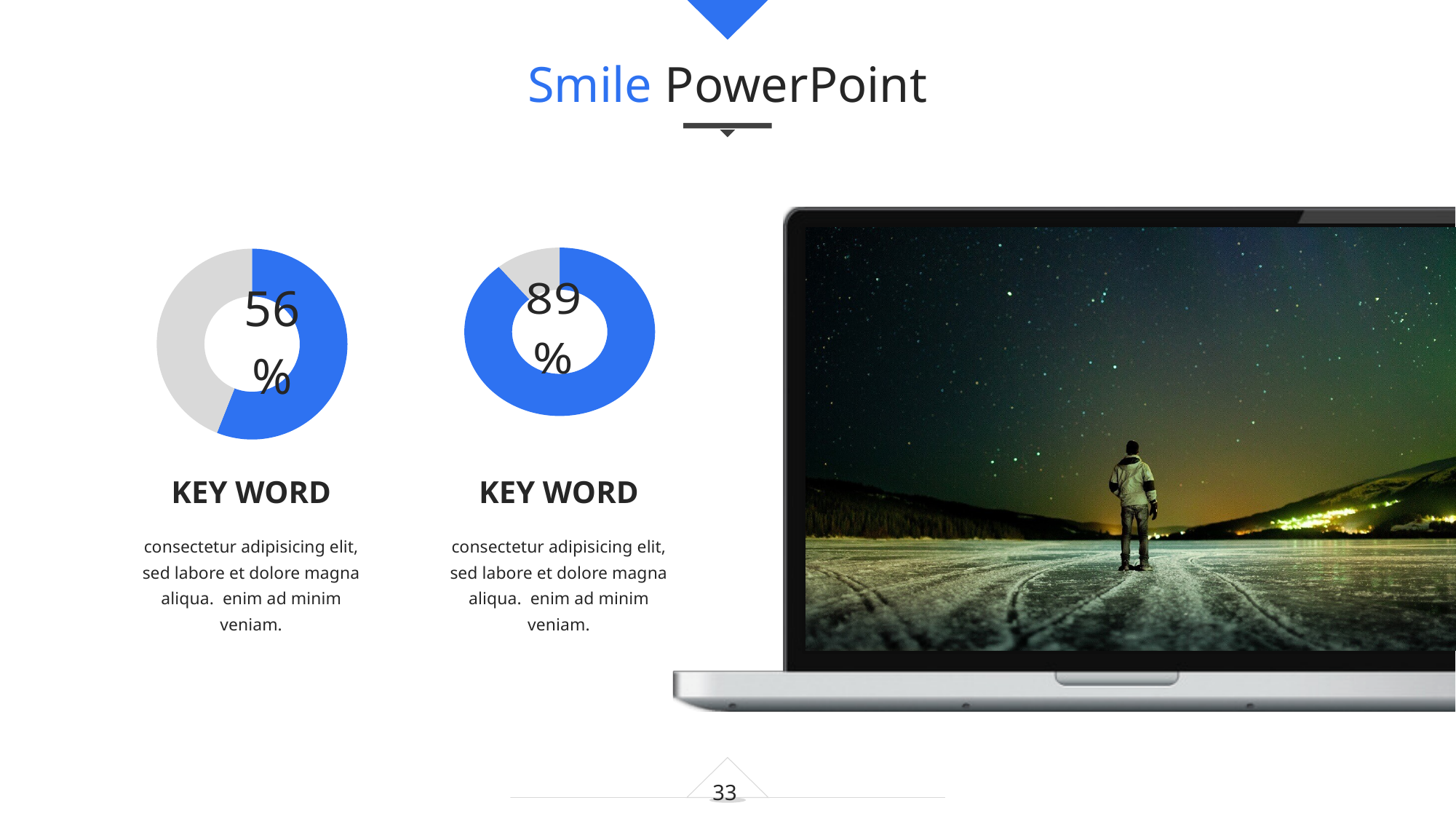
Which donut chart shows the higher percentage, the left one or the right one? the right one What share of the right donut chart is not filled in blue? 11% What share of the left donut chart is filled in blue? 56% What is the difference between the percentage in the right donut chart and the percentage in the left donut chart? 33% Is the value shown in the left donut chart greater or less than 50%? greater What value is shown in the centre of the right donut chart? 89% What kind of chart is used to display the 56% value on the left? donut chart What heading appears below each donut chart? KEY WORD How many donut charts are shown on the slide? 2 What value is shown in the centre of the left donut chart? 56% What colour is used for the filled portion of both donut charts? blue Is the value shown in the right donut chart greater or less than 90%? less